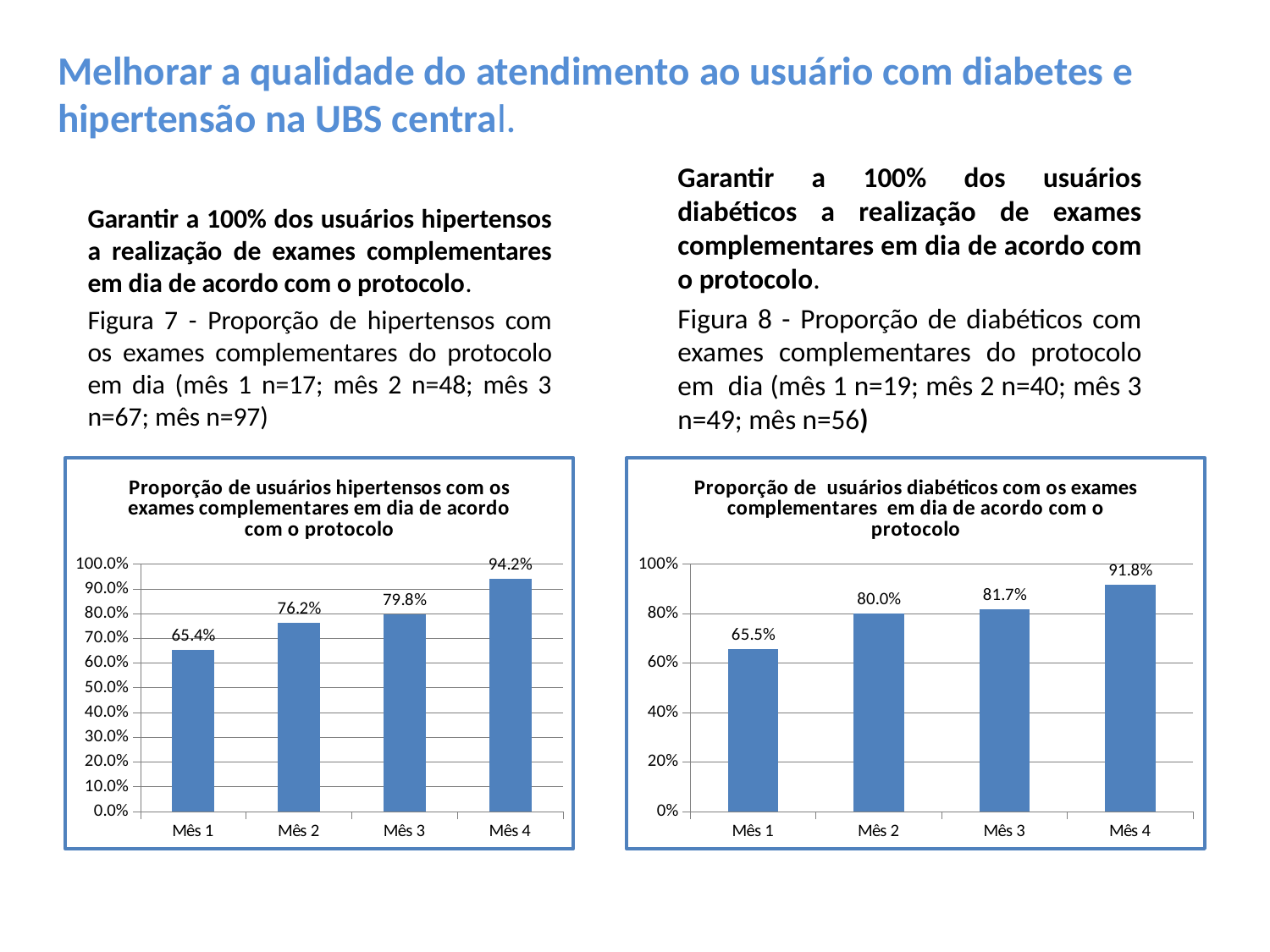
Which is larger: the Mês 2 value in the left chart (hipertensos) or the Mês 2 value in the right chart (diabéticos)? Right chart (diabéticos), 80.0% How many months are plotted in the right chart (diabéticos)? 4 In the right chart (diabéticos), do the values rise or fall from Mês 1 to Mês 4? Rise In the left chart (hipertensos), which month has the highest value? Mês 4 In the left chart (hipertensos), is the value for Mês 3 greater or less than 70.0%? greater In the left chart (hipertensos), what is the value for Mês 1? 65.4% What kind of chart is the left chart (hipertensos)? Bar chart In the right chart (diabéticos), which month has the lowest value? Mês 1 In the left chart (hipertensos), what is the difference between the values for Mês 4 and Mês 1? 28.8% In the right chart (diabéticos), what is the difference between the values for Mês 2 and Mês 1? 14.5% In the right chart (diabéticos), what is the value for Mês 3? 81.7% What is the title of the right chart? Proporção de usuários diabéticos com os exames complementares em dia de acordo com o protocolo